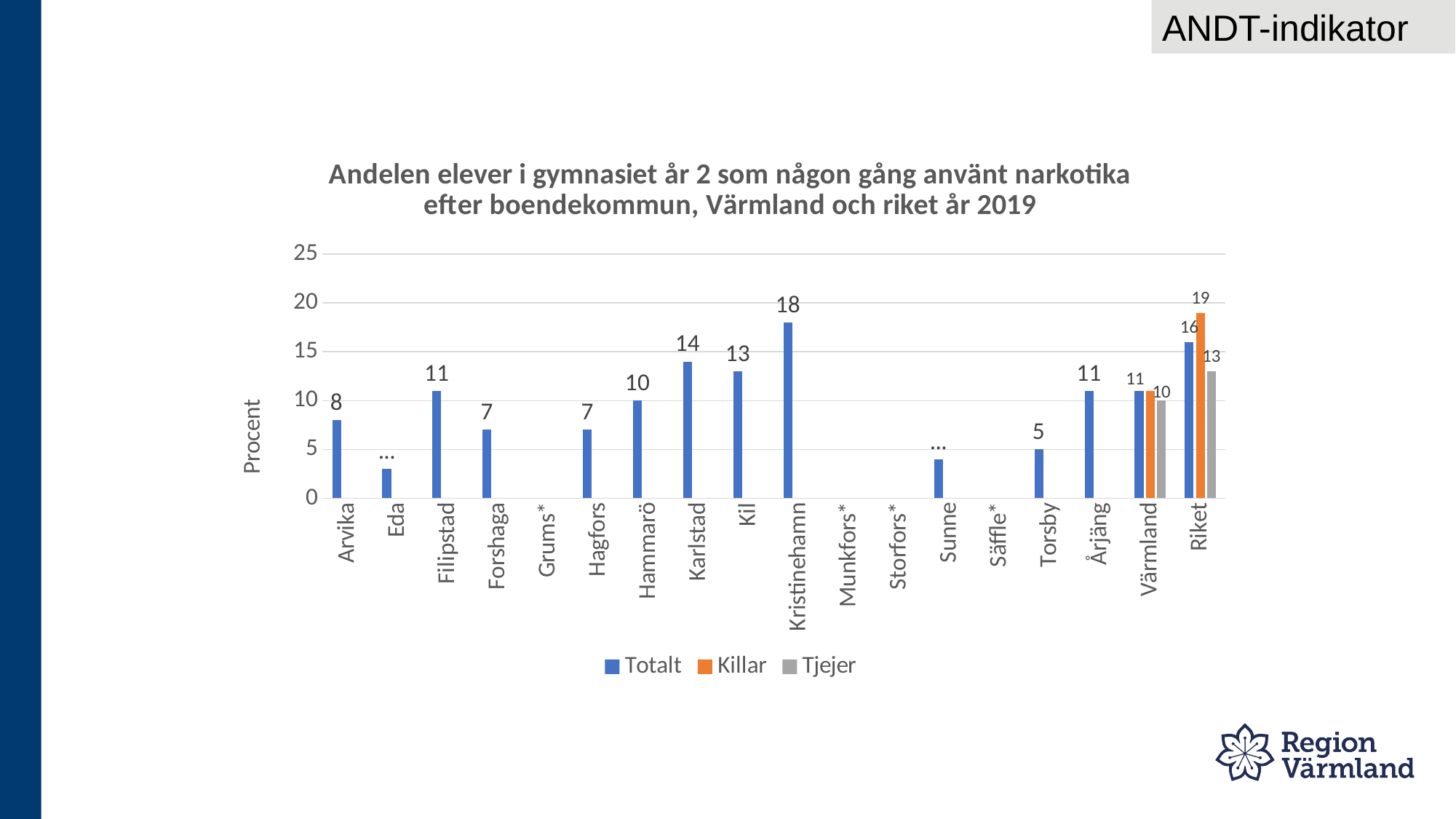
Which has a higher Totalt value, Karlstad or Kil? Karlstad What is the Tjejer value for Värmland? 10 What is the Killar value for Riket? 19 What is the difference between the Killar and Tjejer values for Riket? 6 What is the Totalt value for Kristinehamn? 18 Which category has the highest Totalt value? Kristinehamn What is the difference between the Totalt values for Kristinehamn and Arvika? 10 What kind of chart is shown on the slide? bar chart Is the Totalt value for Eda greater or less than 5? less How many categories are shown on the x axis? 18 How many series does the legend list? 3 What is the Totalt value for Karlstad? 14